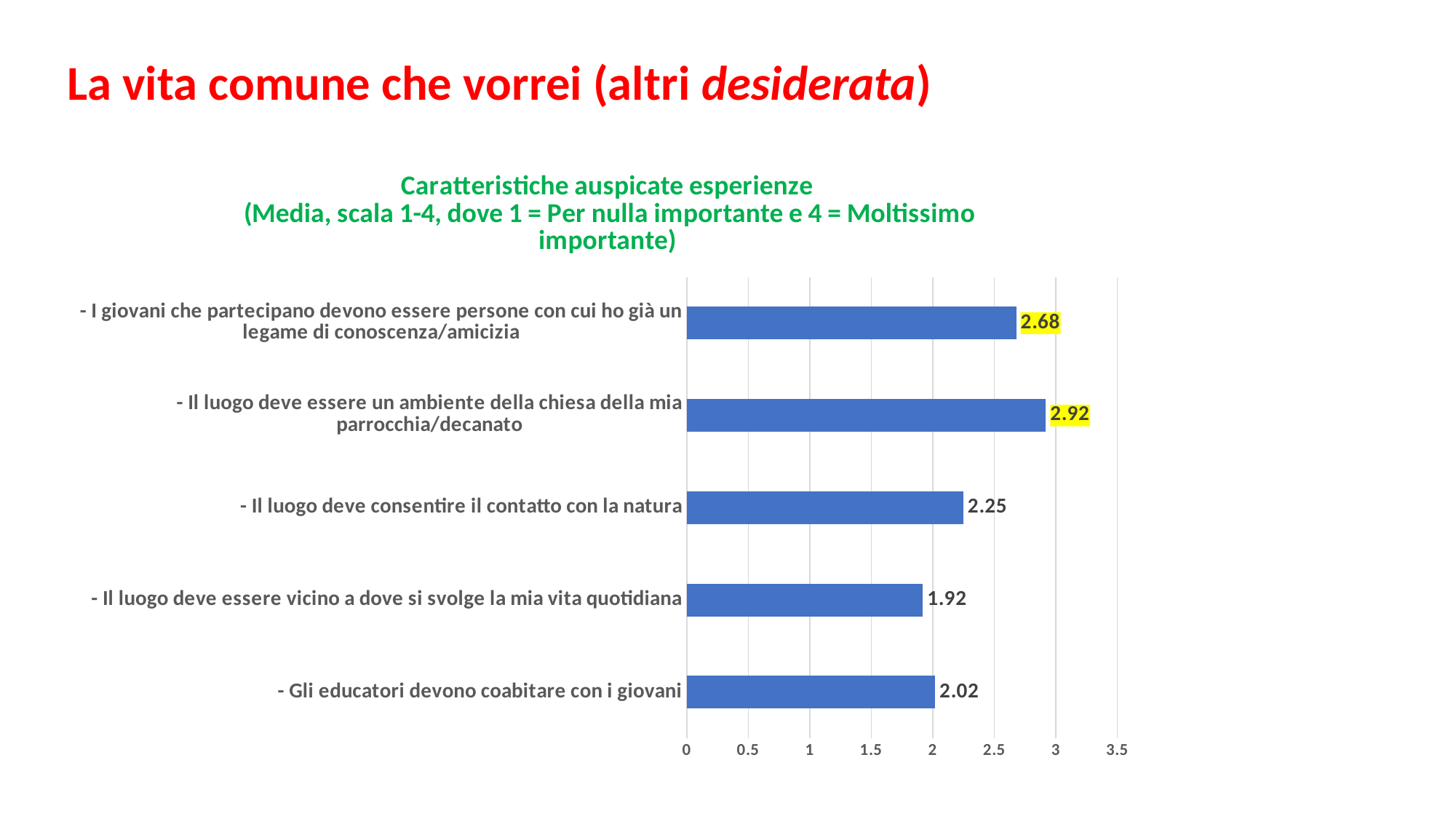
What is the difference between the values for "Il luogo deve essere un ambiente della chiesa della mia parrocchia/decanato" and "I giovani che partecipano devono essere persone con cui ho già un legame di conoscenza/amicizia"? 0.24 What is the value for "Il luogo deve consentire il contatto con la natura"? 2.25 What is the value for "Il luogo deve essere vicino a dove si svolge la mia vita quotidiana"? 1.92 What is the value for "Gli educatori devono coabitare con i giovani"? 2.02 How many categories are shown in the chart? 5 What kind of chart is shown on the slide? Bar chart Is the value for "I giovani che partecipano devono essere persone con cui ho già un legame di conoscenza/amicizia" greater or less than 2.5? greater Which category has the lowest value? Il luogo deve essere vicino a dove si svolge la mia vita quotidiana Which is larger: the value for "Il luogo deve consentire il contatto con la natura" or for "Gli educatori devono coabitare con i giovani"? Il luogo deve consentire il contatto con la natura Which two data labels are highlighted in yellow? 2.68 and 2.92 Which category has the highest value? Il luogo deve essere un ambiente della chiesa della mia parrocchia/decanato What is the difference between the values for "Gli educatori devono coabitare con i giovani" and "Il luogo deve essere vicino a dove si svolge la mia vita quotidiana"? 0.1